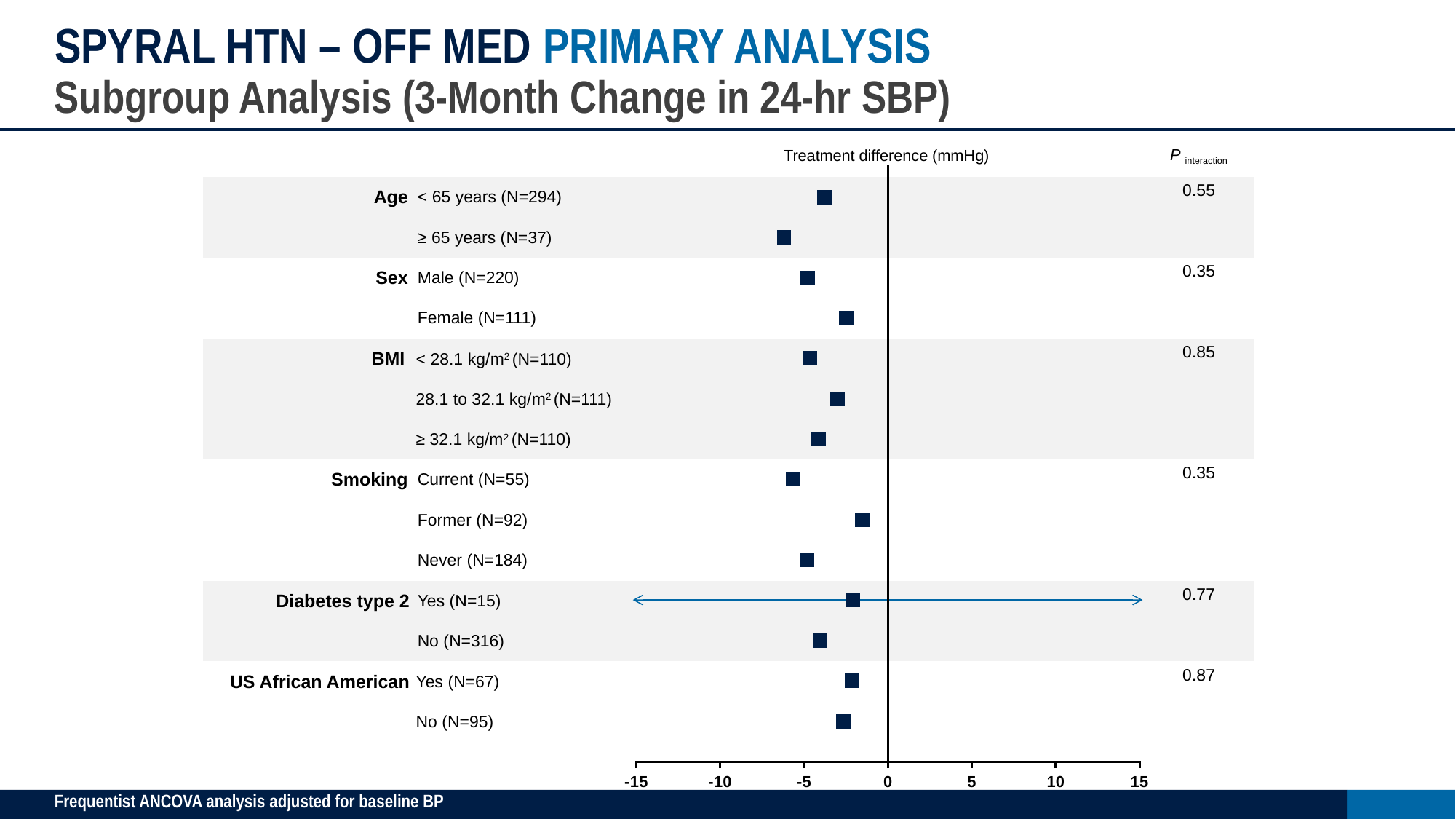
How many subgroup rows are plotted in the forest plot? 14 Is the treatment difference for ≥ 65 years (N=37) greater or less than -5? less What is the P interaction value for the US African American subgroup? 0.87 Which subgroup row shows a confidence interval arrow spanning the full axis width? Diabetes type 2 Yes (N=15) Is the treatment difference for Current smokers (N=55) greater or less than -5? less What is the P interaction value for the BMI subgroup? 0.85 What is the label of the x axis? Treatment difference (mmHg) Is the treatment difference for Former smokers (N=92) greater or less than -5? greater What is the P interaction value for the Age subgroup? 0.55 What is the difference between the P interaction values for US African American and Age? 0.32 Which has the larger (less negative) treatment difference, Male (N=220) or Female (N=111)? Female (N=111) Which subgroup has the highest P interaction value? US African American